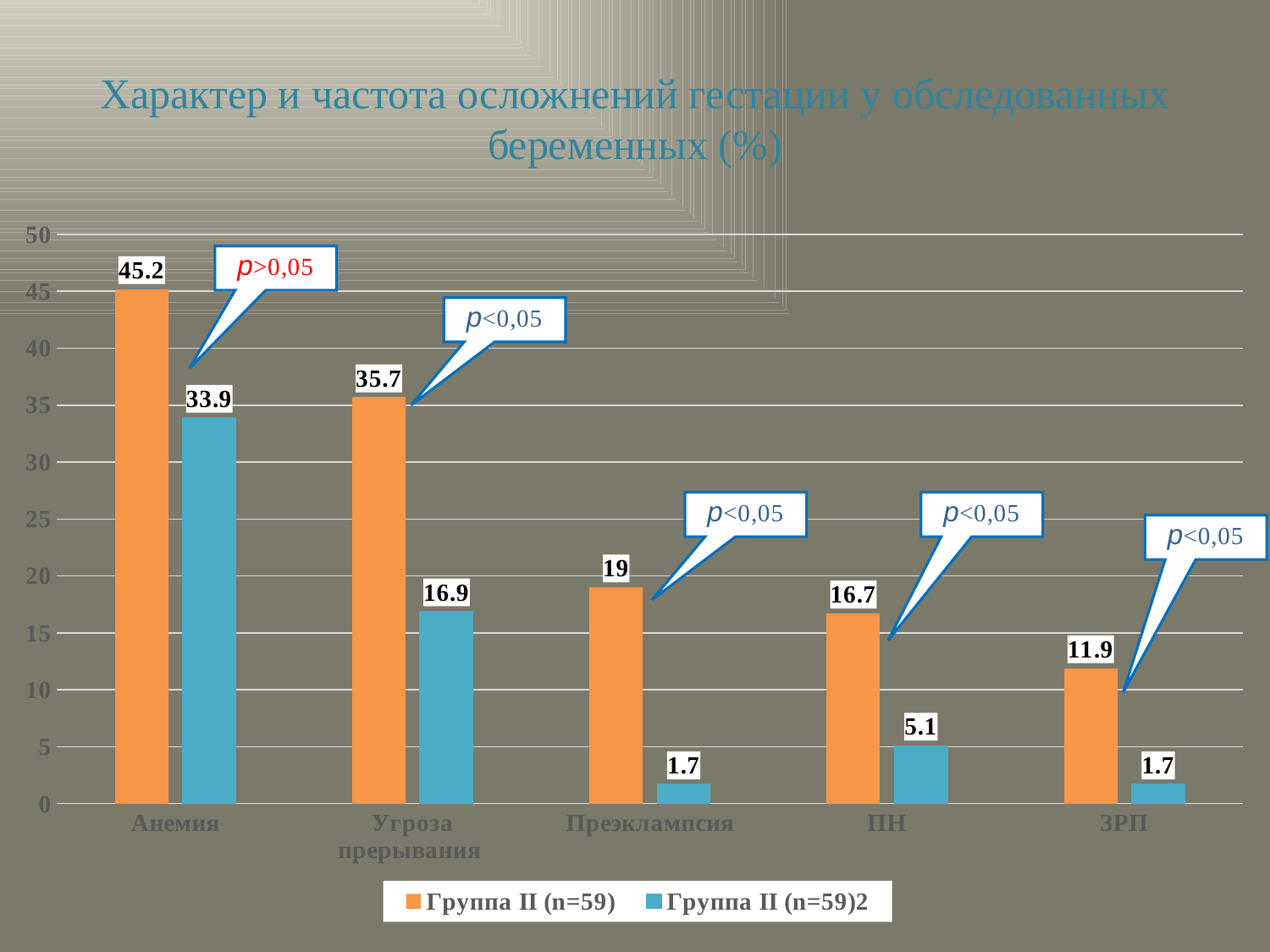
What is the difference between the Группа II (n=59) and Группа II (n=59)2 values for Преэклампсия? 17.3 Which category has the lowest value in the Группа II (n=59) series? ЗРП What is the value for Анемия in the Группа II (n=59) series? 45.2 How many series does the legend list? 2 Do the Группа II (n=59) values rise or fall from Анемия to ЗРП along the x axis? Fall How many categories are shown on the x axis? 5 Which is larger: the Группа II (n=59)2 value for Анемия or the Группа II (n=59) value for Угроза прерывания? Группа II (n=59) value for Угроза прерывания What is the value for Угроза прерывания in the Группа II (n=59)2 series? 16.9 What is the difference between the Группа II (n=59) values for Анемия and Угроза прерывания? 9.5 What kind of chart is shown on the slide? Bar chart What is the value for ПН in the Группа II (n=59)2 series? 5.1 Which category has the highest value in the Группа II (n=59) series? Анемия